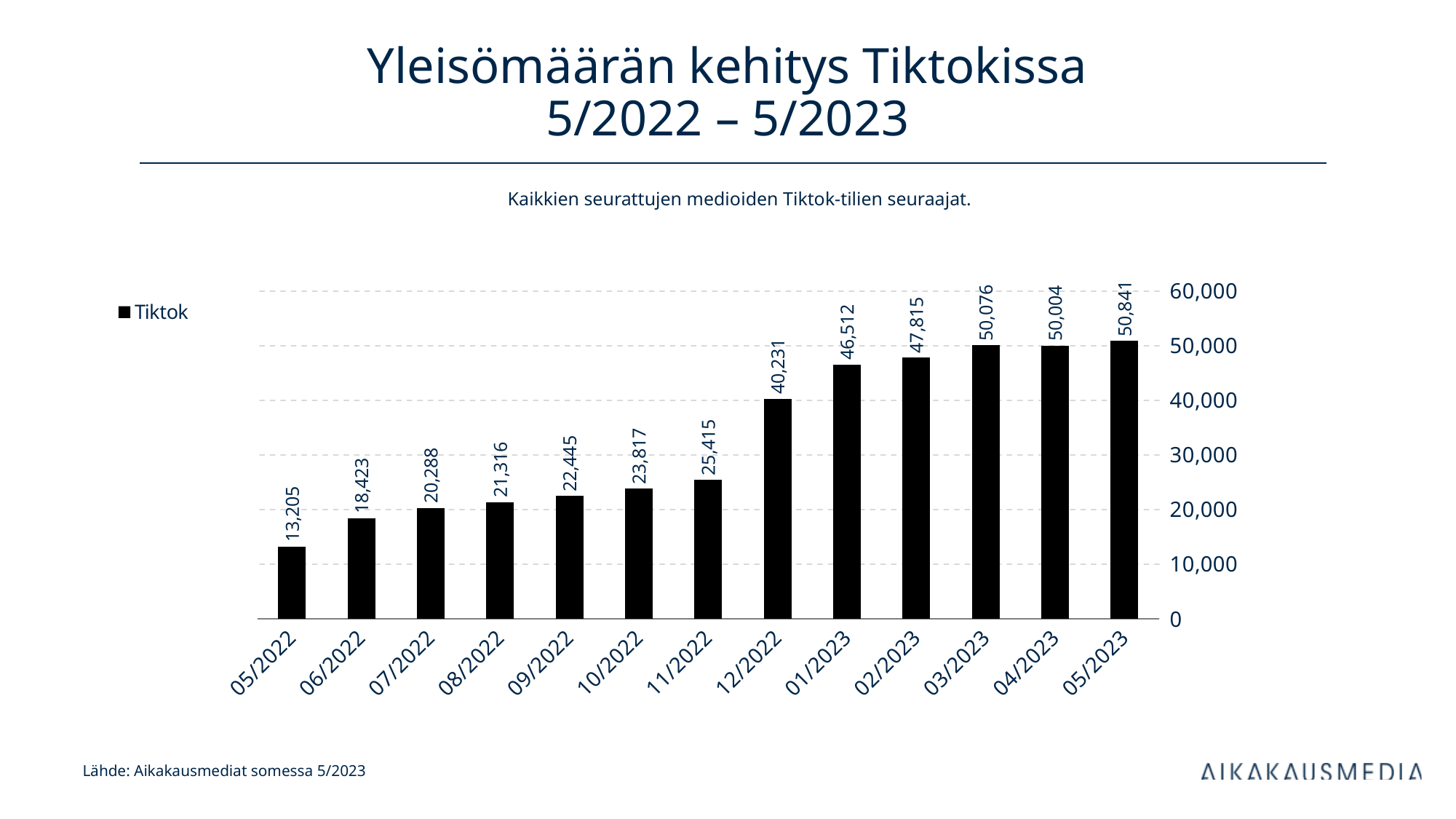
How many months are shown on the x axis? 13 Which is larger, the value for 03/2023 or the value for 04/2023? 03/2023 What is the value for 05/2022? 13,205 How many series does the legend list? 1 What is the difference between the values for 12/2022 and 11/2022? 14,816 What kind of chart is shown? bar chart Which month has the highest value? 05/2023 What is the value for 12/2022? 40,231 Which month has the lowest value? 05/2022 What is the difference between the values for 05/2023 and 05/2022? 37,636 What is the value for 03/2023? 50,076 Do the values generally rise or fall from 05/2022 to 05/2023? rise